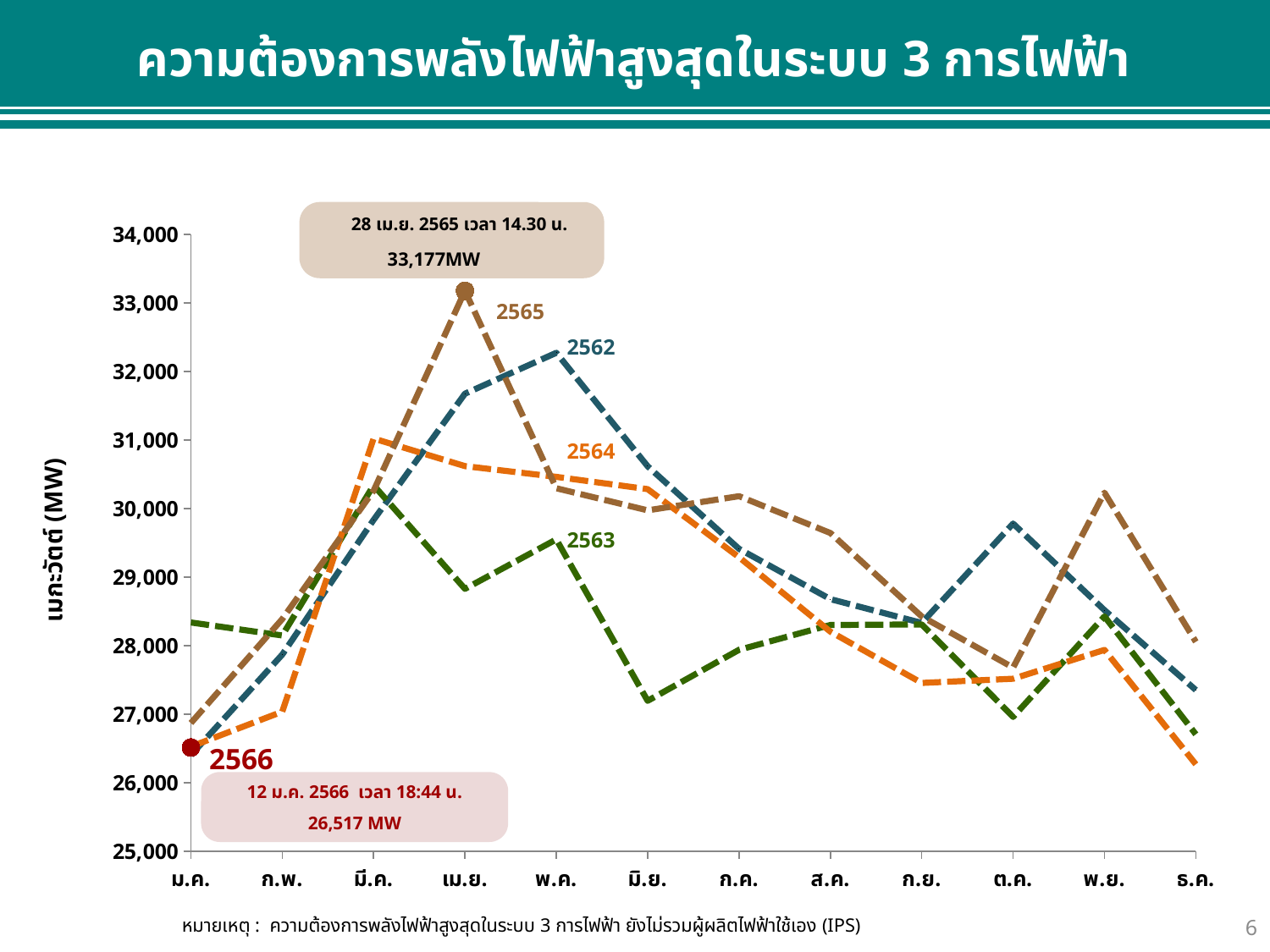
What is the value labelled for the 2566 point in ม.ค.? 26,517 MW Is the value for the 2562 series in เม.ย. greater or less than 31,000? greater In ธ.ค., which series has the larger value, 2565 or 2564? 2565 Which year's series has the lowest value in ธ.ค.? 2564 Is the value for the 2563 series in มิ.ย. greater or less than 28,000? less What is the peak value labelled for the 2565 series in เม.ย.? 33,177MW Does the 2565 series rise or fall from เม.ย. to ต.ค.? fall How many months are shown along the x axis of the chart? 12 What kind of chart is shown on the slide? line chart Which year's series reaches the highest value on the chart? 2565 How many years (series) are labelled on the chart? 5 What is the difference between the labelled 2565 peak (33,177MW) and the labelled 2566 value (26,517 MW)? 6,660 MW